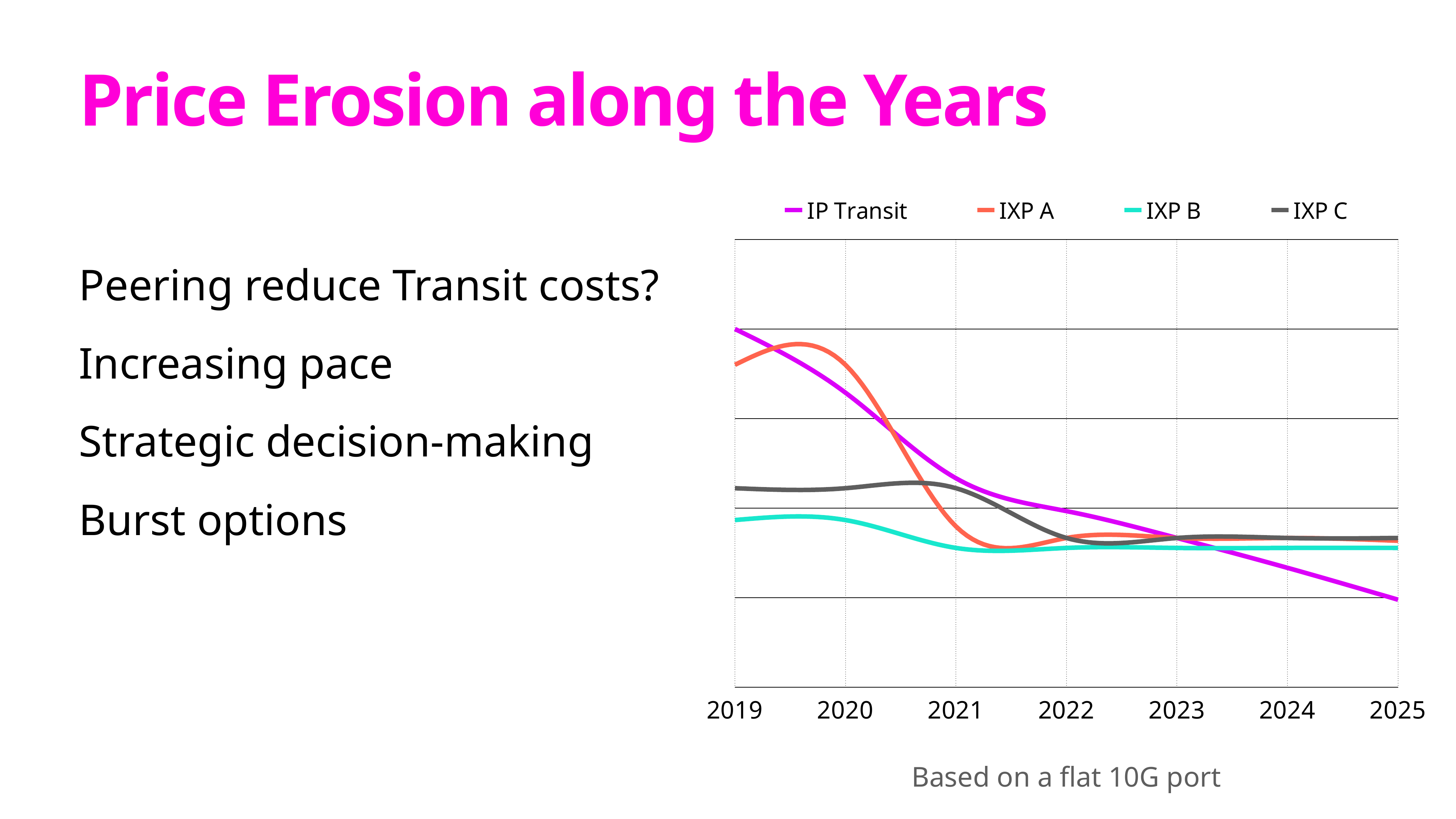
In 2019, which is higher: IXP C or IXP B? IXP C Which series is lowest in 2025? IP Transit Which series is lowest in 2019? IXP B Does the IP Transit line rise or fall from 2019 to 2025? fall In 2021, which is higher: IXP C or IXP A? IXP C How many series does the chart legend list? 4 Which series is drawn in orange? IXP A How many years are labelled on the x axis of the chart? 7 In 2020, which is higher: IXP A or IP Transit? IXP A Which series is highest in 2019? IP Transit What note appears below the chart? Based on a flat 10G port What kind of chart is shown on the slide? line chart